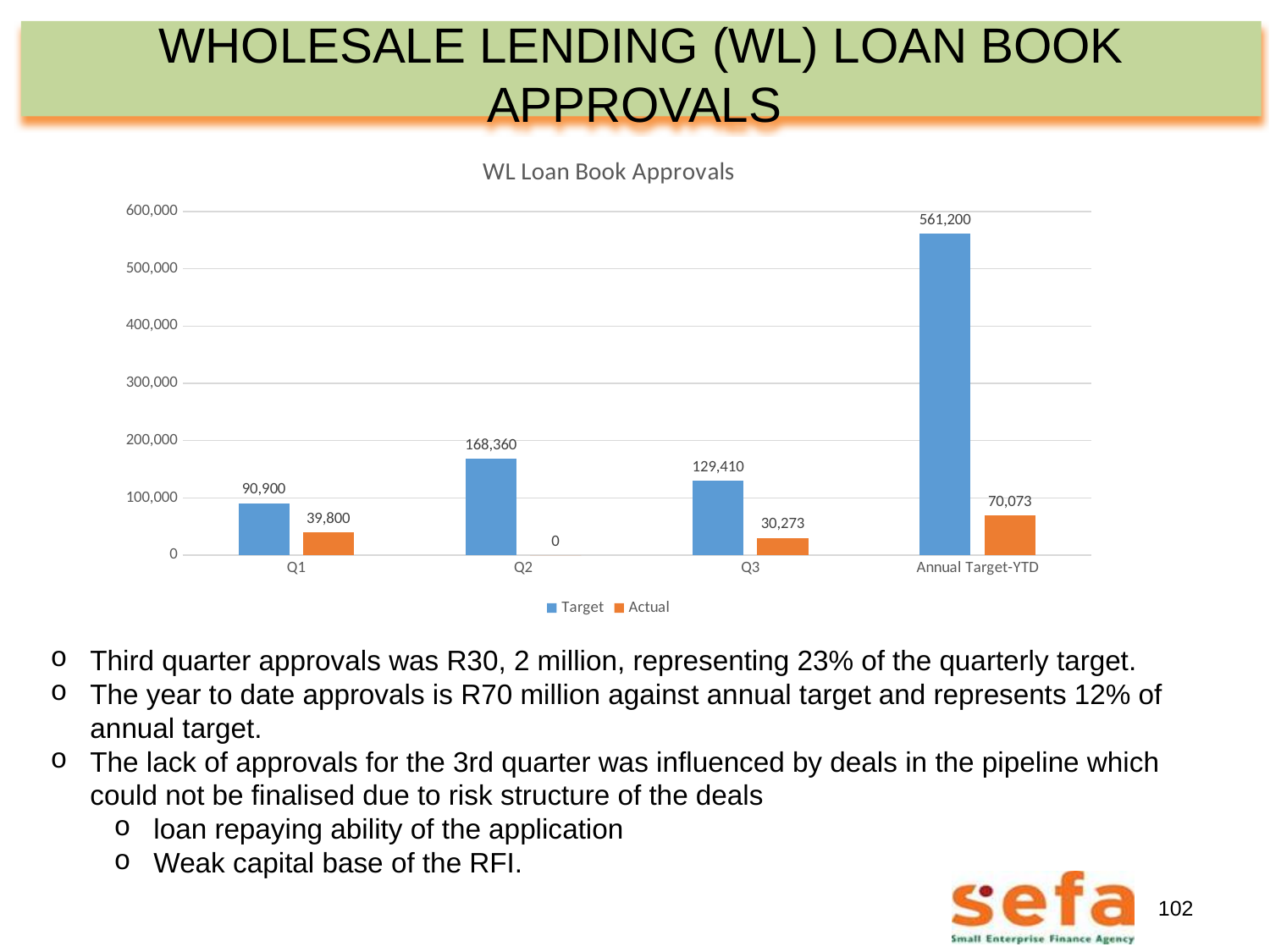
What is the Target value for Q1? 90,900 What is the Actual value for Q2? 0 How many series does the legend list? 2 What is the title of the chart? WL Loan Book Approvals Which is larger, the Target value for Q2 or the Target value for Q3? Q2 Which category has the highest Target value? Annual Target-YTD How many categories are shown on the x axis? 4 What kind of chart is shown on the slide? Bar chart What is the Actual value for Q3? 30,273 What is the difference between the Target and Actual values for Q1? 51,100 Which category has the lowest Actual value? Q2 What is the Actual value for Annual Target-YTD? 70,073